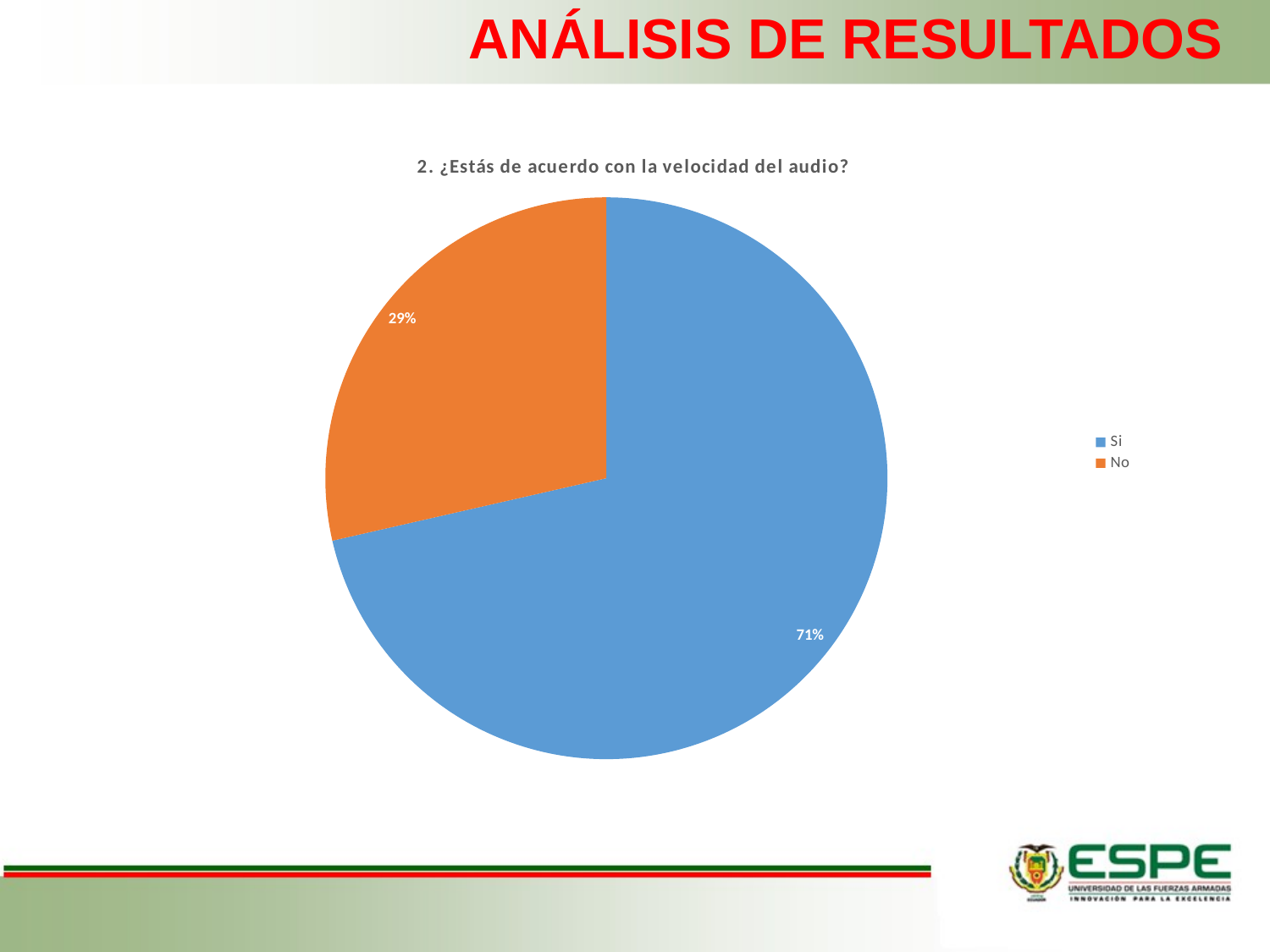
How many slices does the pie chart have? 2 What is the title of the chart? 2. ¿Estás de acuerdo con la velocidad del audio? Which slice is the smallest in the pie chart? No What percentage of the pie is labelled for the 'No' slice? 29% What kind of chart is shown on the slide? pie chart Which is larger, the 'Si' slice or the 'No' slice? Si What is the difference in percentage points between the 'Si' and 'No' slices? 42 How many entries does the legend list? 2 What colour is the 'No' slice? orange What share of the pie does the 'Si' slice represent? 71% Which slice is the largest in the pie chart? Si What percentage of the pie is labelled for the 'Si' slice? 71%